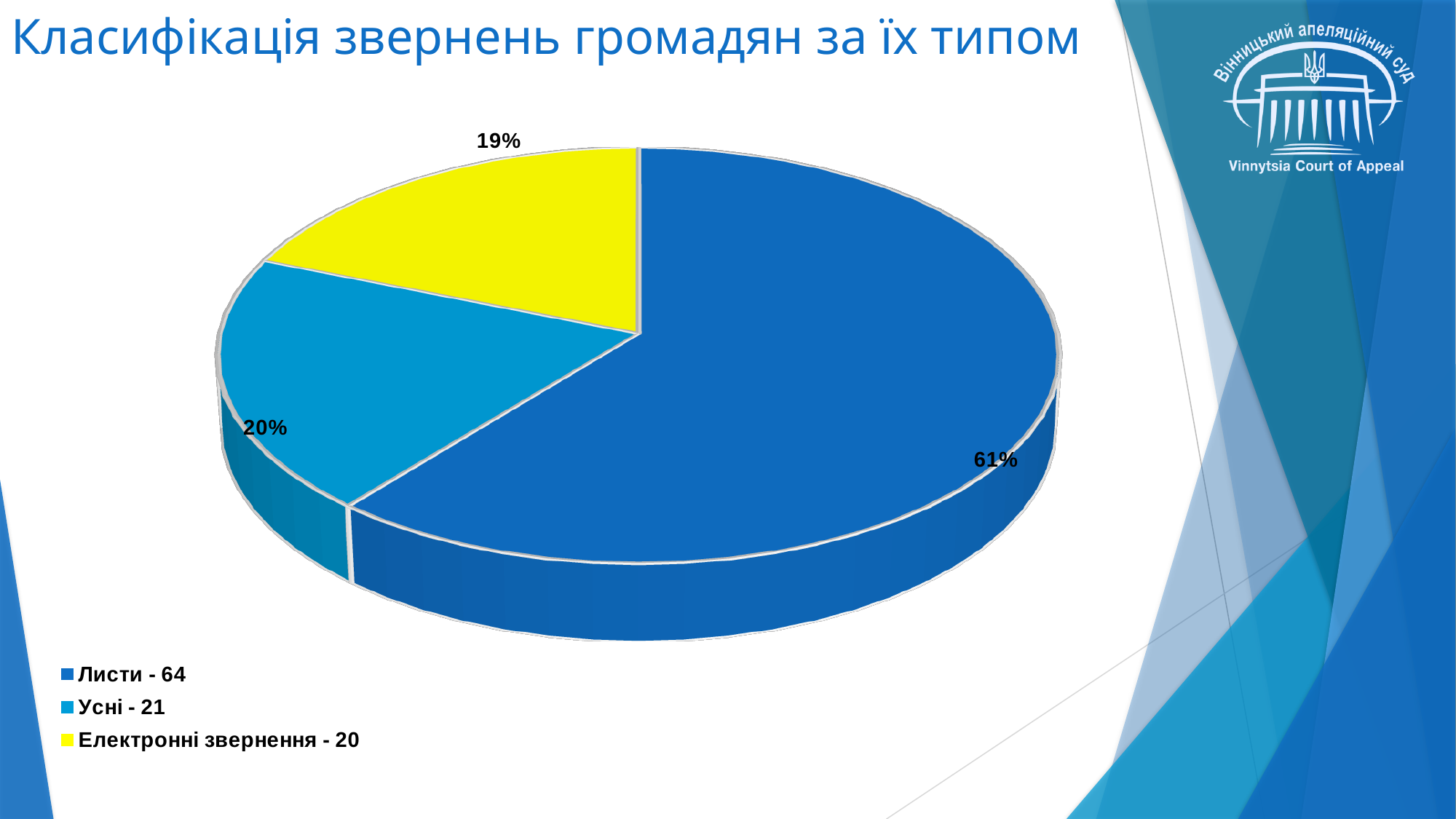
What is the title of the chart? Класифікація звернень громадян за їх типом How many Листи are shown in the legend? 64 What is the difference in percentage points between the Листи slice and the Електронні звернення slice? 42% Which category has the smallest slice of the pie? Електронні звернення Which colour represents Електронні звернення in the chart? yellow What kind of chart is shown on the slide? pie chart Which category has the largest slice of the pie? Листи What share of the pie does Листи take? 61% How many slices does the pie chart have? 3 What share of the pie does Усні take? 20% How many Усні are shown in the legend? 21 What share of the pie does Електронні звернення take? 19%